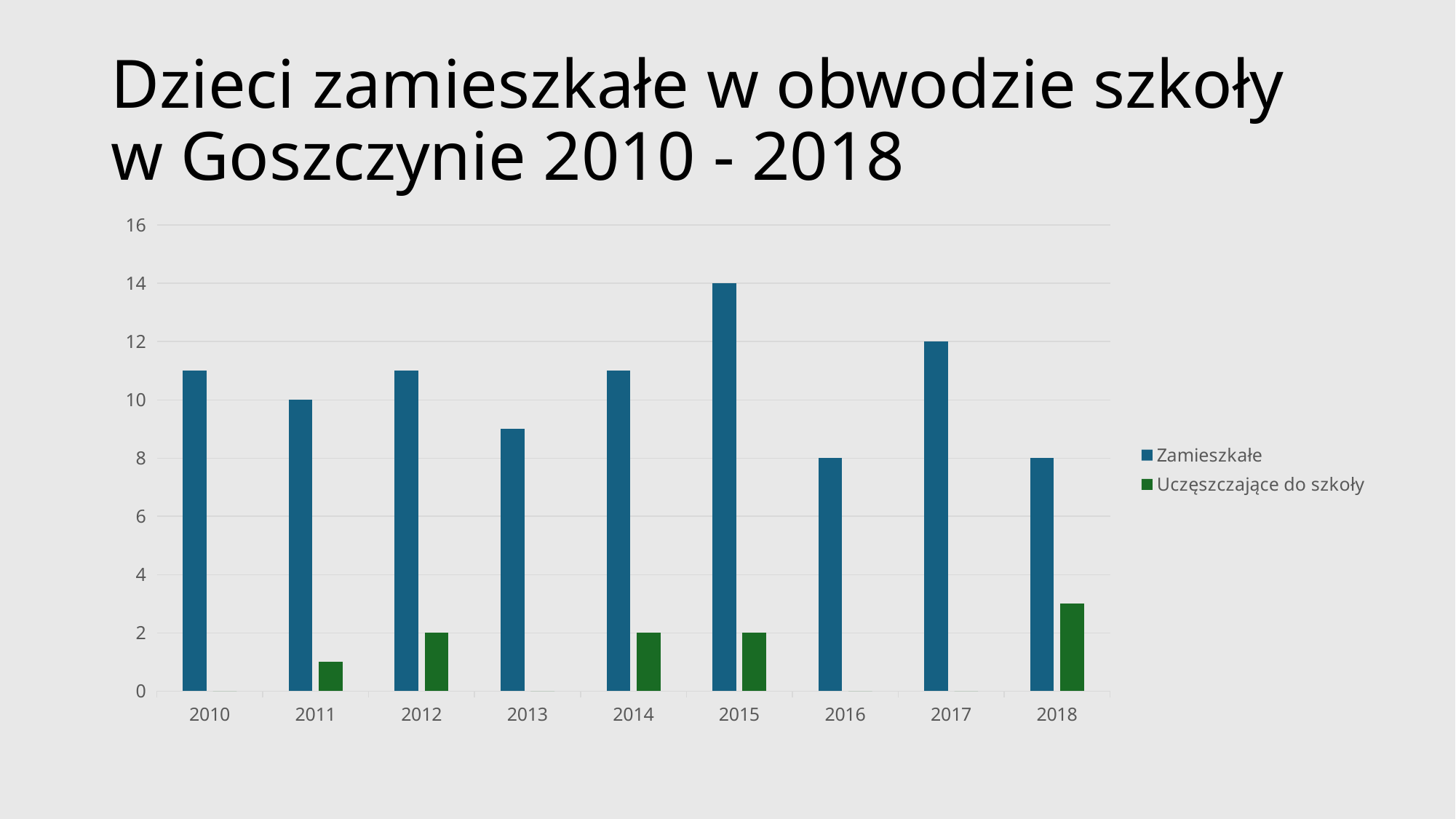
How many series does the legend list? 2 What is the value of Uczęszczające do szkoły for 2014? 2 Is the value of Zamieszkałe for 2013 greater or less than 10? less What is the value of Zamieszkałe for 2017? 12 What is the value of Zamieszkałe for 2015? 14 What is the difference between the Zamieszkałe values for 2017 and 2016? 4 What type of chart is shown on the slide? bar chart What is the value of Zamieszkałe for 2016? 8 Which is larger, the Zamieszkałe value for 2011 or for 2013? 2011 Which year has the highest value for Uczęszczające do szkoły? 2018 Which year has the highest value for Zamieszkałe? 2015 How many years are shown on the x axis? 9